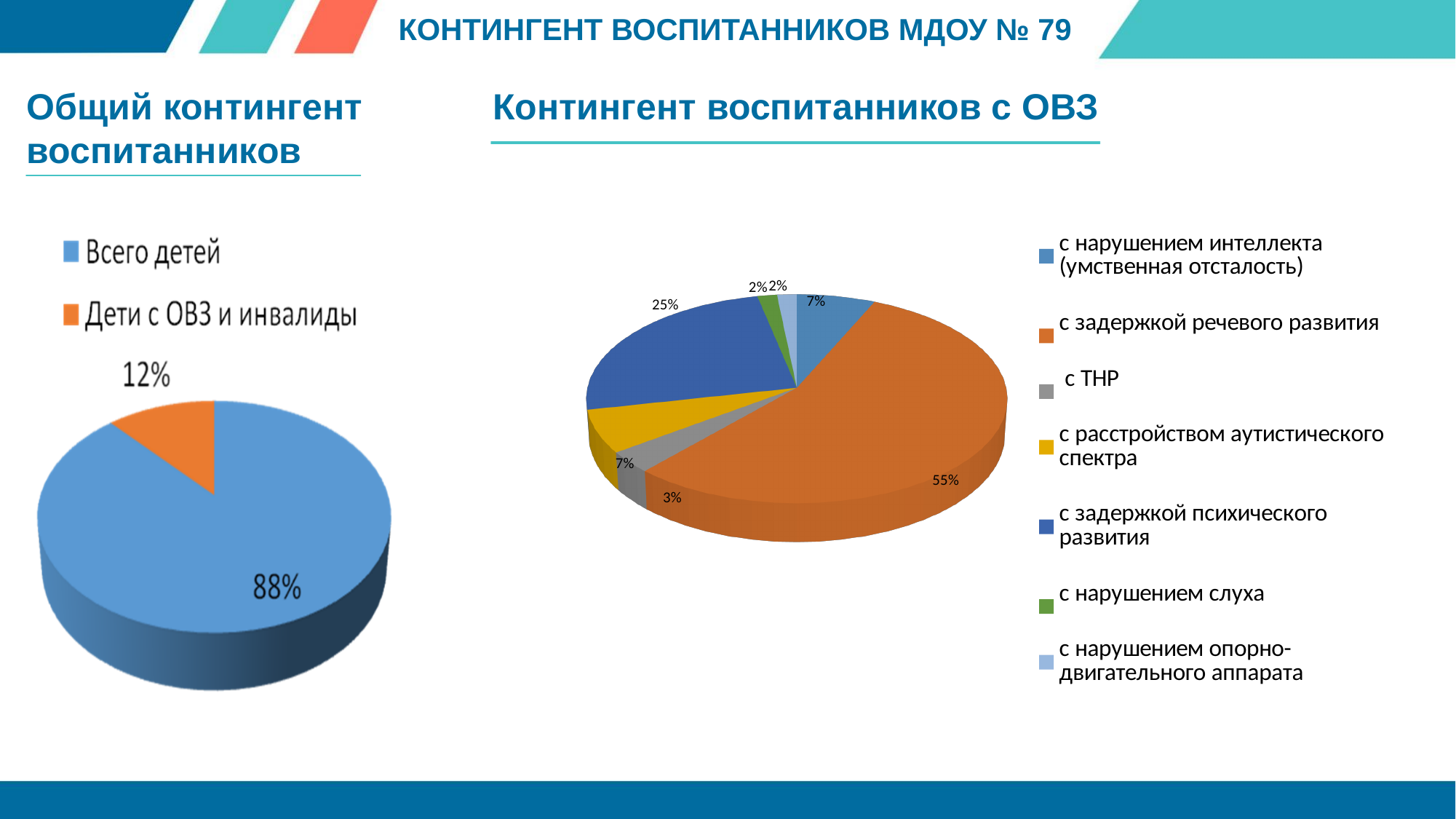
In the chart 'Общий контингент воспитанников', what share is labelled for 'Дети с ОВЗ и инвалиды'? 12% In the chart 'Контингент воспитанников с ОВЗ', which category has the largest share? с задержкой речевого развития How many entries does the legend of the chart 'Контингент воспитанников с ОВЗ' list? 7 In the chart 'Контингент воспитанников с ОВЗ', what is the difference between the shares for 'с задержкой речевого развития' and 'с задержкой психического развития'? 30% What kind of chart is 'Общий контингент воспитанников'? Pie chart In the chart 'Контингент воспитанников с ОВЗ', what colour is the slice for 'с задержкой речевого развития'? Orange In the chart 'Контингент воспитанников с ОВЗ', what share is labelled for 'с задержкой речевого развития'? 55% In the chart 'Контингент воспитанников с ОВЗ', which is larger: the share for 'с ТНР' or the share for 'с расстройством аутистического спектра'? с расстройством аутистического спектра In the chart 'Контингент воспитанников с ОВЗ', what share is labelled for 'с задержкой психического развития'? 25% In the chart 'Контингент воспитанников с ОВЗ', what share is labelled for 'с нарушением слуха'? 2% In the chart 'Общий контингент воспитанников', what share is labelled for 'Всего детей'? 88% In the chart 'Контингент воспитанников с ОВЗ', what share is labelled for 'с ТНР'? 3%